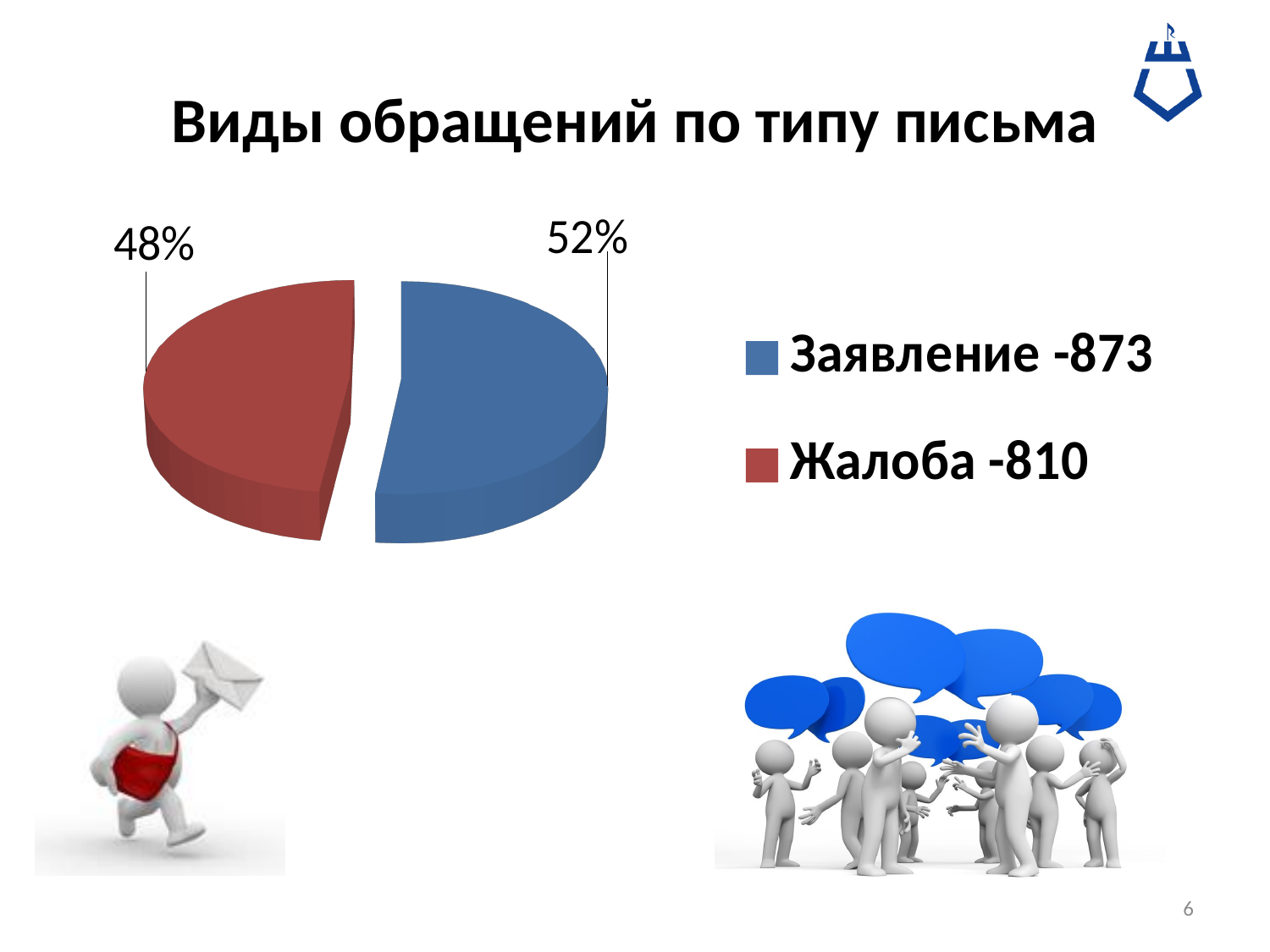
Which category has the larger share of the pie? Заявление What is the difference between the counts for Заявление and Жалоба? 63 How many slices does the pie chart have? 2 Which colour represents Жалоба in the pie chart? red What is the number shown for Заявление in the legend? 873 What share of the pie does Жалоба take? 48% What share of the pie does Заявление take? 52% What is the title of the chart? Виды обращений по типу письма What is the number shown for Жалоба in the legend? 810 What type of chart is shown on the slide? pie chart Which category has the smaller share of the pie? Жалоба How many entries does the legend list? 2